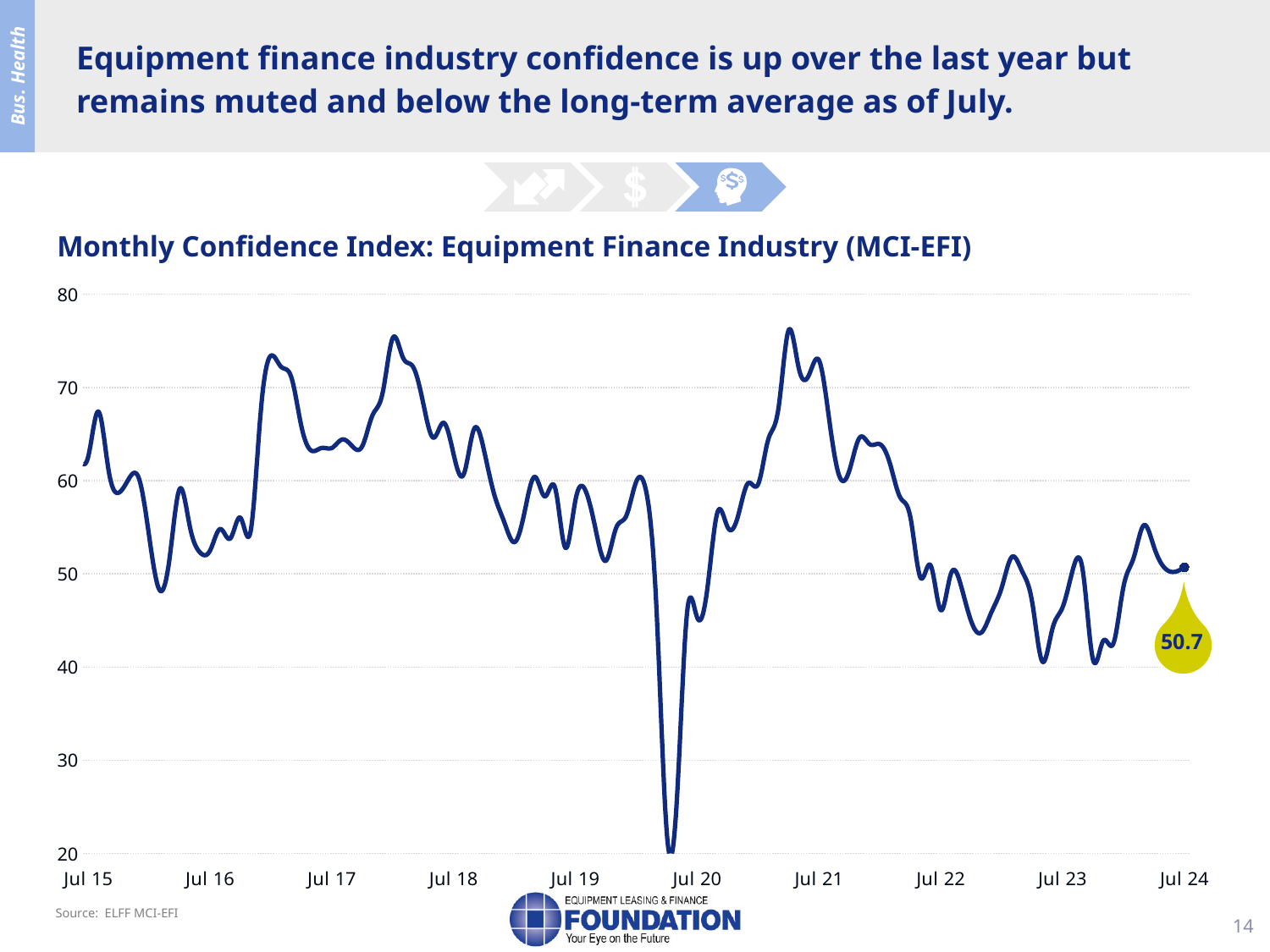
What kind of chart is used to show the Monthly Confidence Index? Line chart Which is higher, the index value at Jul 21 or at Jul 24? Jul 21 What source is cited for the chart? ELFF MCI-EFI Is the value of the index at Jul 24 greater or less than 60? less What is the value of the Monthly Confidence Index at Jul 24, as labeled on the chart? 50.7 Is the value of the index at Jul 21 greater or less than 70? greater What is the title of the chart? Monthly Confidence Index: Equipment Finance Industry (MCI-EFI) Is the lowest point of the line greater or less than 30? less Does the index rise or fall between Jul 23 and Jul 24? Rise How many labeled points are there on the x axis? 10 Does the index rise or fall between Jul 21 and Jul 22? Fall